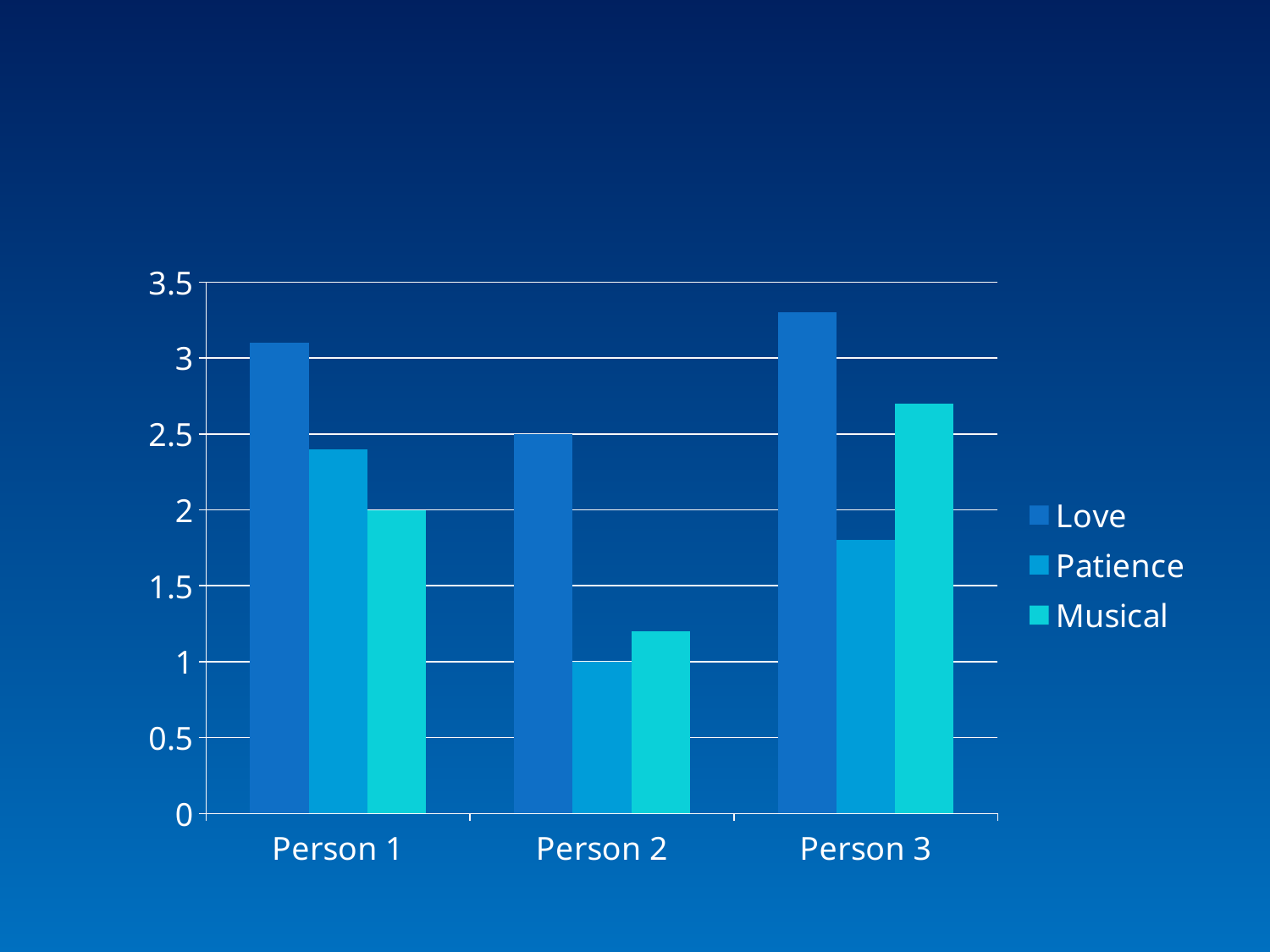
How many persons (categories) are shown on the x axis? 3 What is the Patience value for Person 2? 1 Which person has the lowest Patience value? Person 2 What is the Musical value for Person 1? 2 Which person has the highest Love value? Person 3 Is the Love value for Person 1 greater or less than 3? greater How many series does the legend list? 3 Is the Musical value for Person 3 larger than the Musical value for Person 1? Yes What kind of chart is shown on the slide? Bar chart Is the Patience value for Person 3 greater or less than 2? less What is the difference between the Love and Patience values for Person 2? 1.5 What is the Love value for Person 2? 2.5